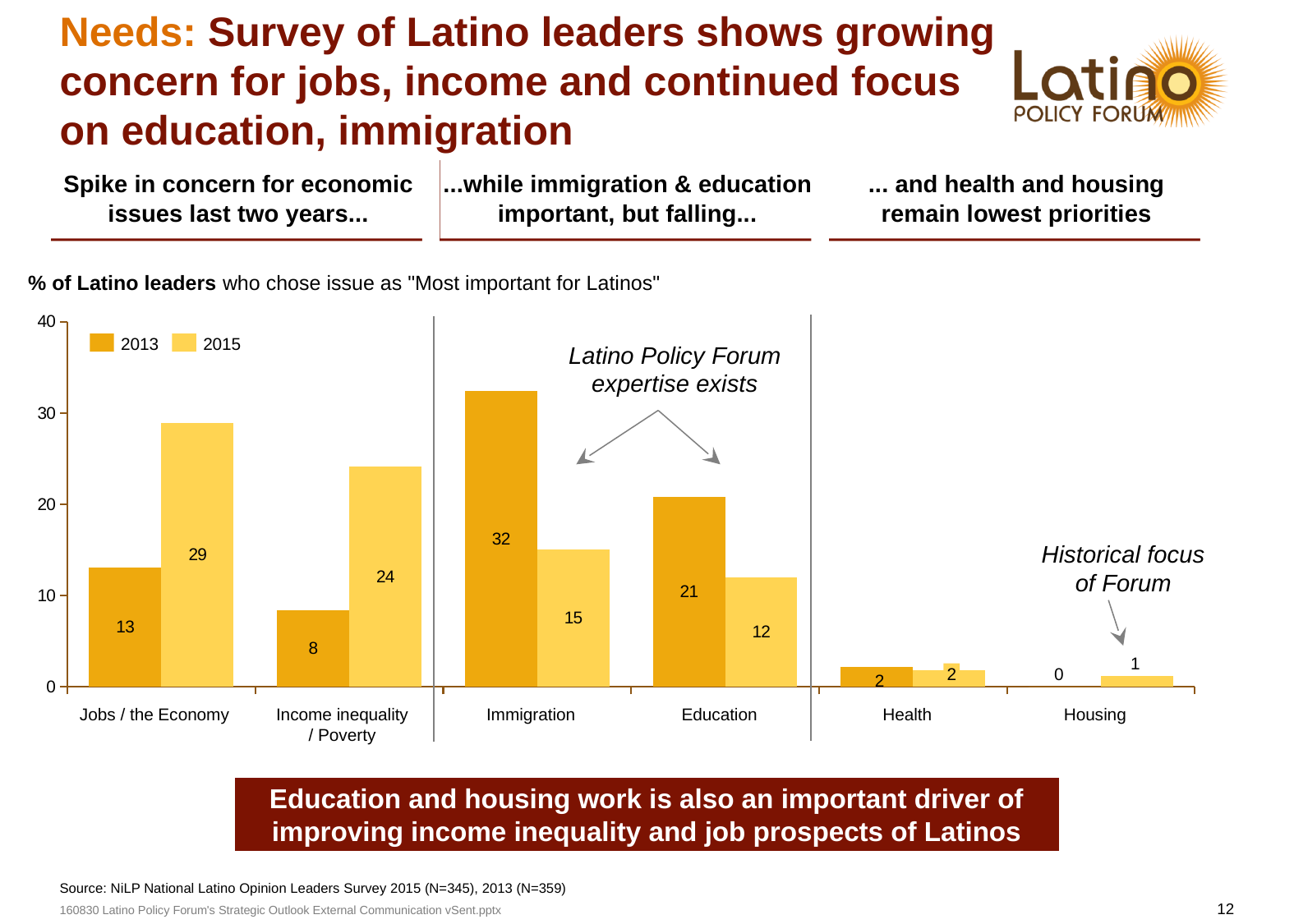
What is the 2015 value for Income inequality / Poverty? 24 Is the 2013 value for Education greater or less than 30? less How many series does the legend list? 2 Which category has the highest 2013 value? Immigration What is the difference between the 2013 and 2015 values for Immigration? 17 Which is larger, the 2015 value for Education or the 2015 value for Immigration? Immigration What percentage of Latino leaders chose Jobs / the Economy as most important in 2015? 29 What is the difference between the 2015 and 2013 values for Jobs / the Economy? 16 How many issue categories are shown on the x axis? 6 What kind of chart is shown on the slide? bar chart Which category has the lowest 2013 value? Housing What is the 2013 value for Immigration? 32